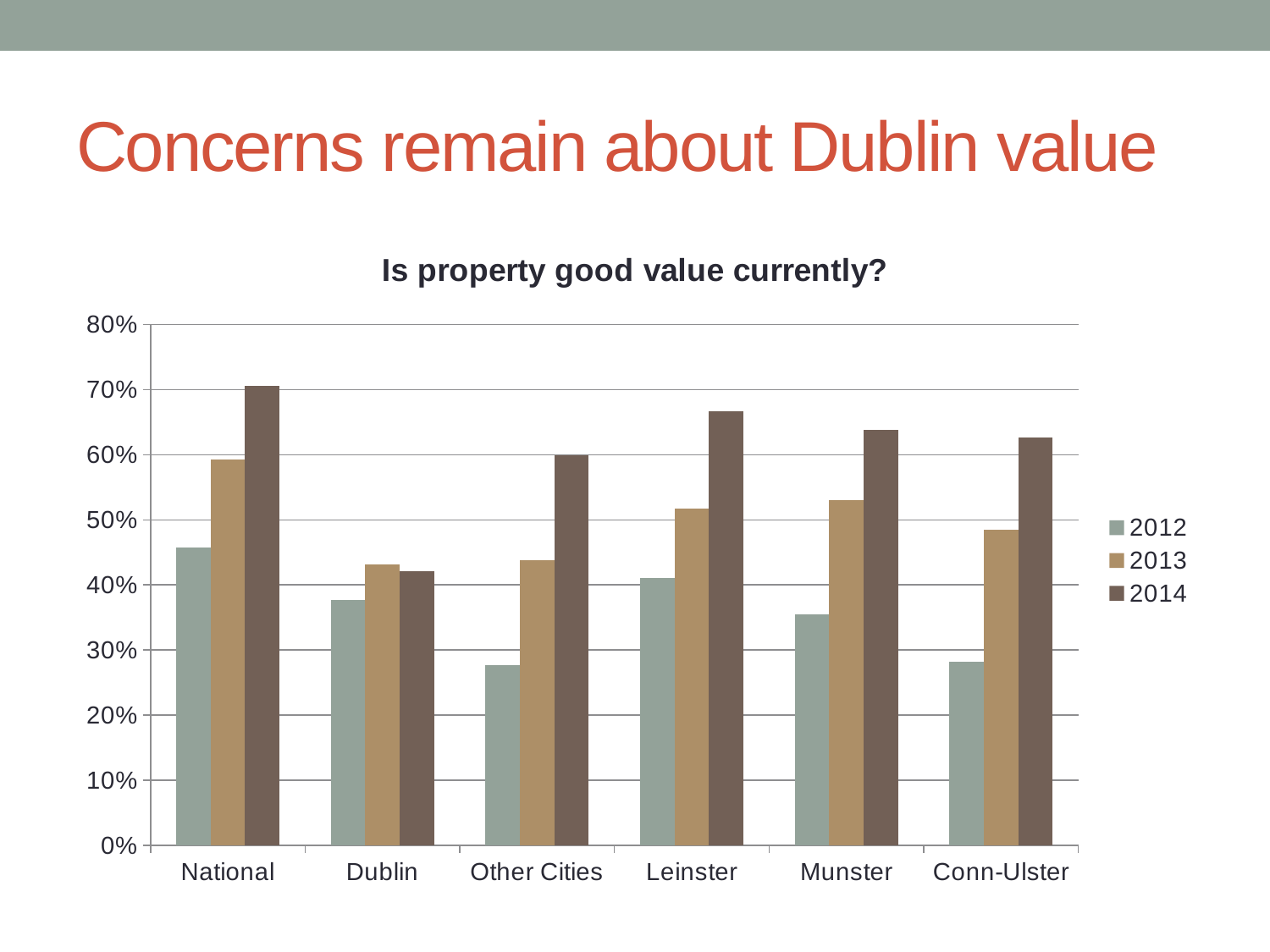
What kind of chart is shown on the slide? bar chart Which is larger: the 2013 value for National or the 2013 value for Leinster? National Is the value for Dublin in 2012 greater or less than 40%? less Is the value for Conn-Ulster in 2012 greater or less than 30%? less For Other Cities, do the values rise or fall from 2012 to 2014? rise Which category has the highest value for 2013? National Which category has the highest value for 2014? National What is the title of the chart? Is property good value currently? How many categories are shown on the x axis? 6 Which category has the lowest value for 2014? Dublin How many series does the legend list? 3 Is the value for National in 2014 greater or less than 60%? greater